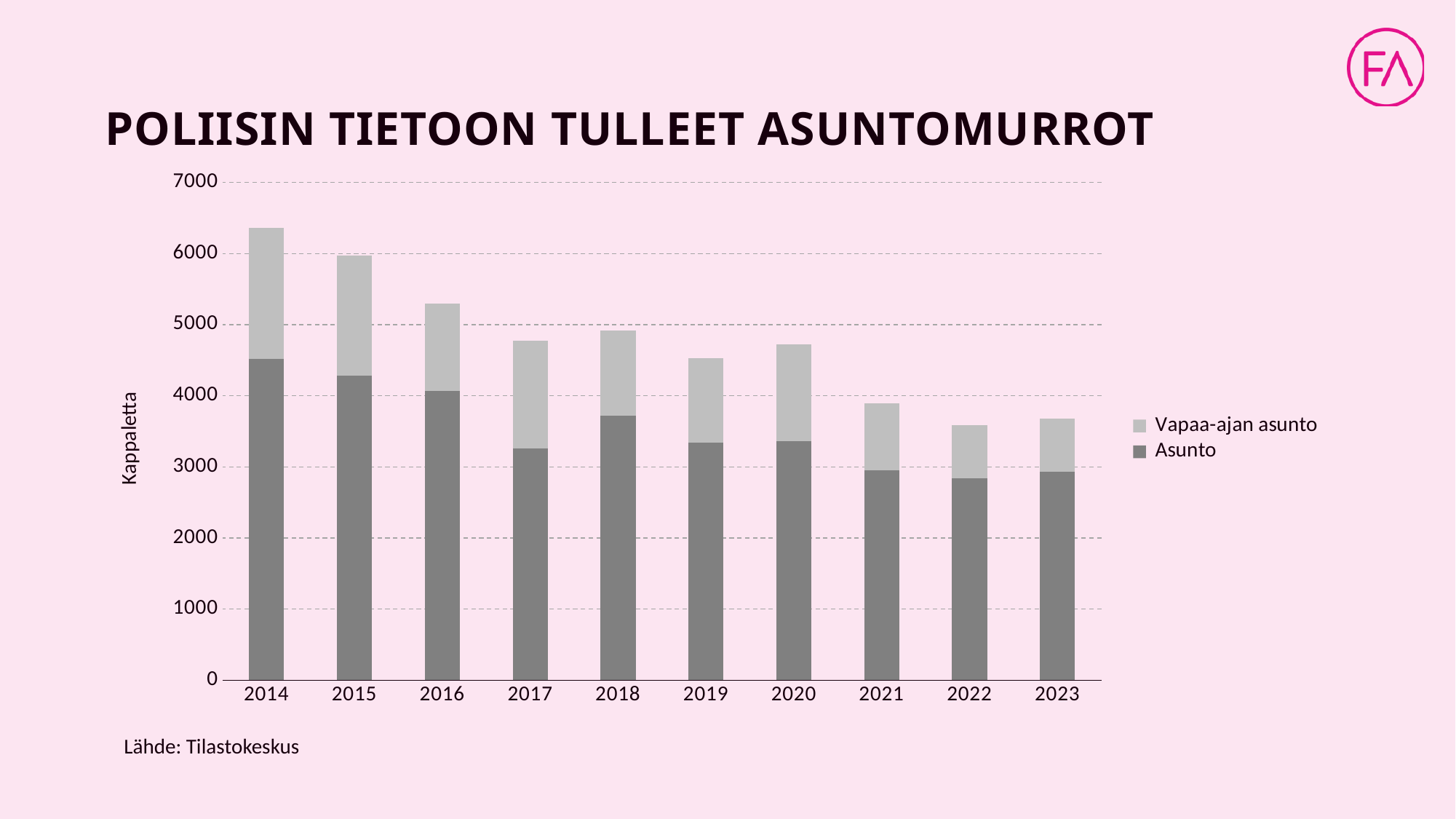
Which year has the larger total stacked bar, 2017 or 2018? 2018 What is the label on the y axis of the chart? Kappaletta Is the Asunto value for 2022 greater or less than 3000? less Is the total value for 2020 greater or less than 4000? greater How many series does the legend list? 2 How many years are shown on the x axis of the chart? 10 Do the total values generally rise or fall from 2014 to 2023? fall Is the Asunto value for 2017 greater or less than 4000? less What kind of chart is shown on the slide? Stacked bar chart Which year has the highest total number of burglaries (tallest stacked bar)? 2014 Which year has the larger Asunto value, 2014 or 2015? 2014